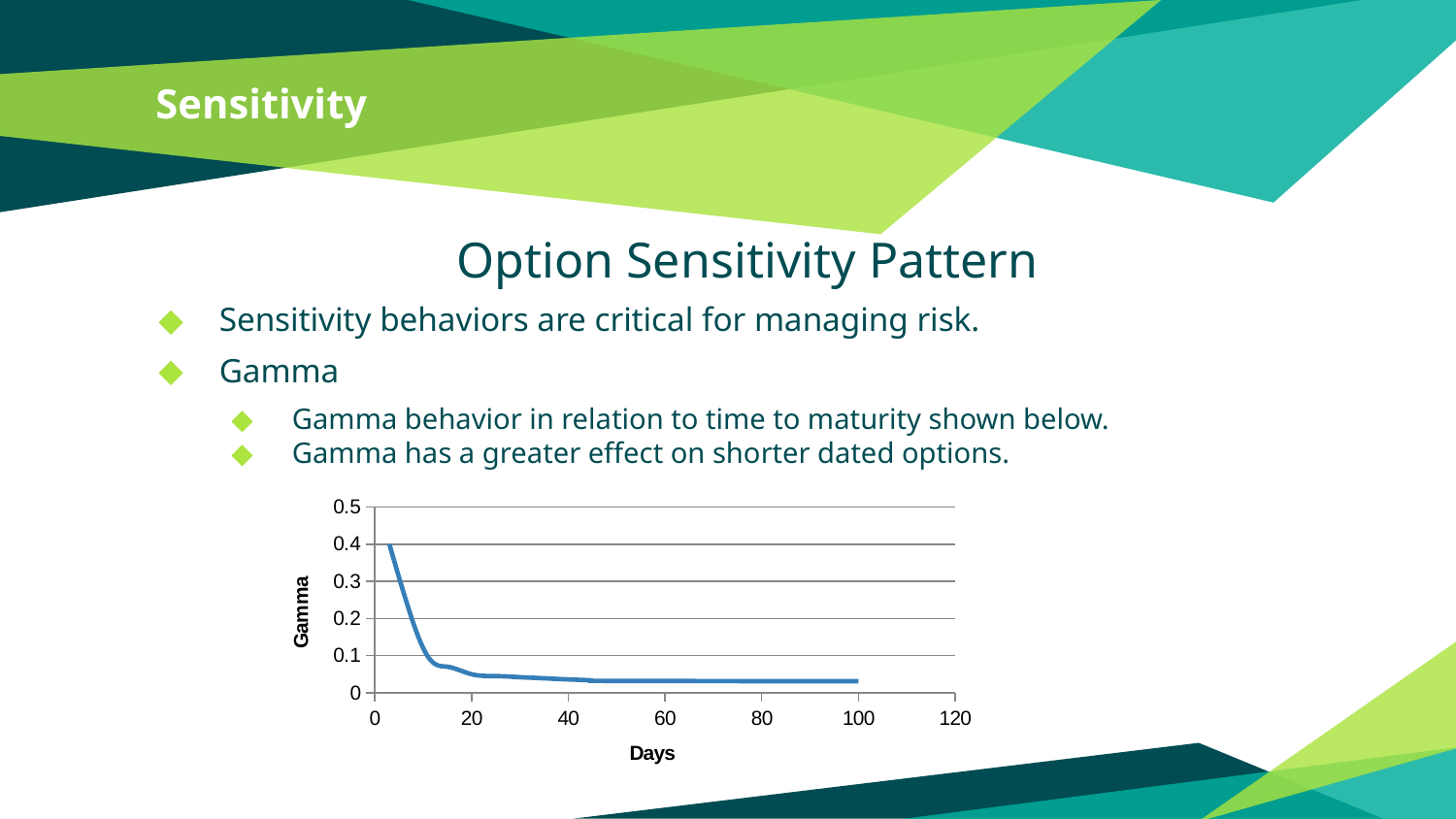
What kind of chart is shown on the slide? line chart Does Gamma rise or fall as Days increases along the x axis? fall What is the label of the x axis of the chart? Days Is the Gamma value at 100 days greater or less than 0.1? less Is the Gamma value at 20 days greater or less than 0.1? less Is the Gamma value at 40 days greater or less than 0.1? less Near which end of the Days axis does Gamma reach its highest value? the left end, near 0 days Is Gamma larger at 5 days or at 50 days? 5 days What is the label of the y axis of the chart? Gamma Is Gamma larger at 20 days or at 100 days? 20 days